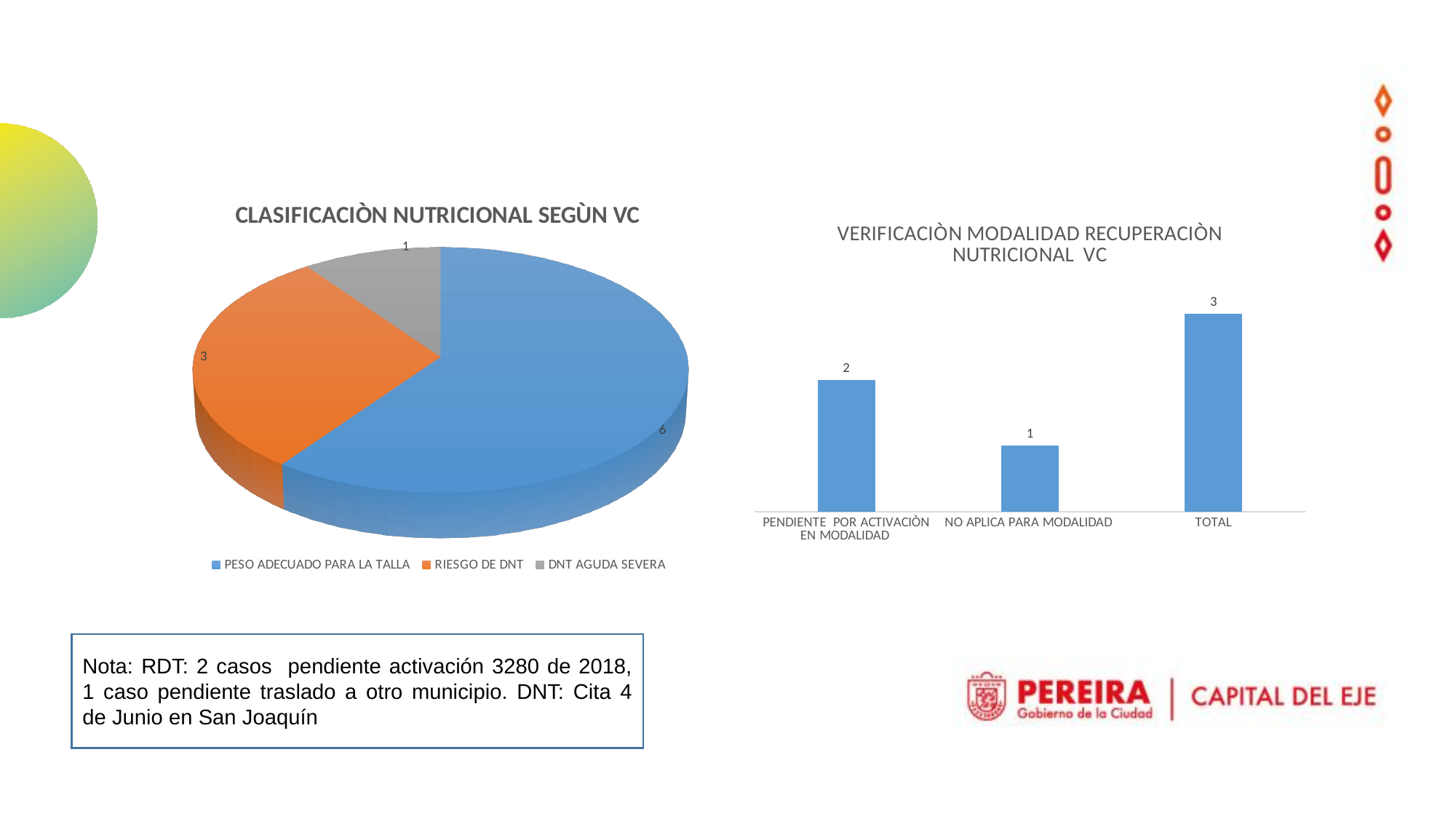
In the chart titled VERIFICACIÒN MODALIDAD RECUPERACIÒN NUTRICIONAL VC, which category has the highest value? TOTAL In the pie chart titled CLASIFICACIÒN NUTRICIONAL SEGÙN VC, which category has the smallest slice? DNT AGUDA SEVERA In the pie chart titled CLASIFICACIÒN NUTRICIONAL SEGÙN VC, what is the value for PESO ADECUADO PARA LA TALLA? 6 In the pie chart titled CLASIFICACIÒN NUTRICIONAL SEGÙN VC, what share of the total does PESO ADECUADO PARA LA TALLA represent? 60% In the chart titled VERIFICACIÒN MODALIDAD RECUPERACIÒN NUTRICIONAL VC, what is the value for NO APLICA PARA MODALIDAD? 1 In the pie chart titled CLASIFICACIÒN NUTRICIONAL SEGÙN VC, how many categories does the legend list? 3 In the pie chart titled CLASIFICACIÒN NUTRICIONAL SEGÙN VC, what is the value for RIESGO DE DNT? 3 In the chart titled VERIFICACIÒN MODALIDAD RECUPERACIÒN NUTRICIONAL VC, what is the value for PENDIENTE POR ACTIVACIÒN EN MODALIDAD? 2 In the pie chart titled CLASIFICACIÒN NUTRICIONAL SEGÙN VC, which category has the largest slice? PESO ADECUADO PARA LA TALLA What kind of chart is the one titled VERIFICACIÒN MODALIDAD RECUPERACIÒN NUTRICIONAL VC? Bar chart In the chart titled VERIFICACIÒN MODALIDAD RECUPERACIÒN NUTRICIONAL VC, what is the difference between TOTAL and NO APLICA PARA MODALIDAD? 2 In the pie chart titled CLASIFICACIÒN NUTRICIONAL SEGÙN VC, what colour is the RIESGO DE DNT slice? Orange